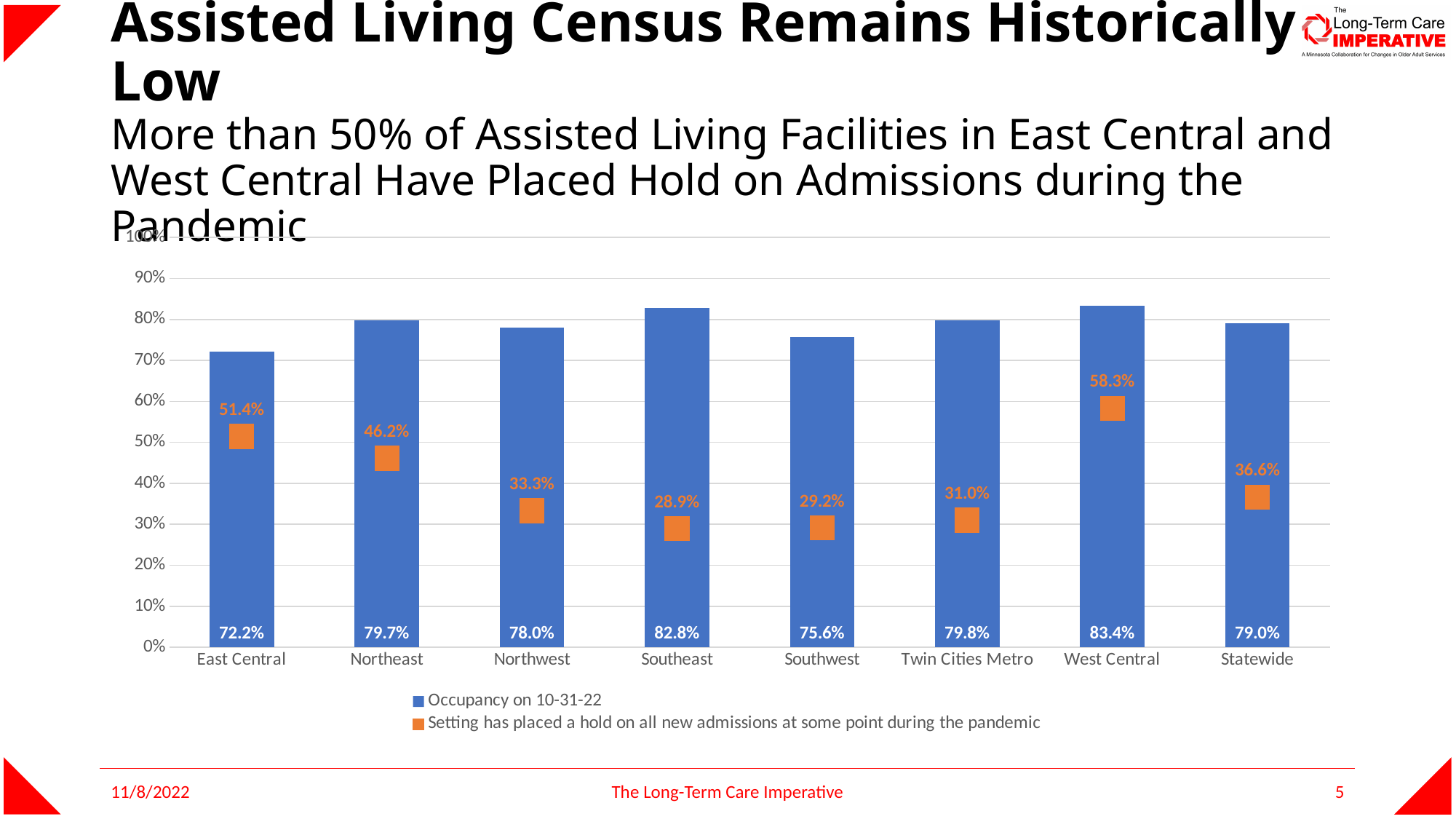
What percentage of settings in West Central have placed a hold on all new admissions at some point during the pandemic? 58.3% Which region has the highest occupancy on 10-31-22? West Central What is the Statewide occupancy on 10-31-22? 79.0% How many series does the chart legend list? 2 What is the difference in occupancy on 10-31-22 between West Central and East Central? 11.2 percentage points Which has a higher share of settings that placed a hold on admissions, East Central or Northeast? East Central How many regions (categories) are shown on the x axis of the chart? 8 Which region has the lowest occupancy on 10-31-22? East Central Which region has the lowest share of settings that placed a hold on all new admissions during the pandemic? Southeast Is the occupancy on 10-31-22 for Southwest greater or less than 80%? less What is the occupancy on 10-31-22 for the Southeast region? 82.8% What kind of chart is used to show occupancy on 10-31-22? Bar chart